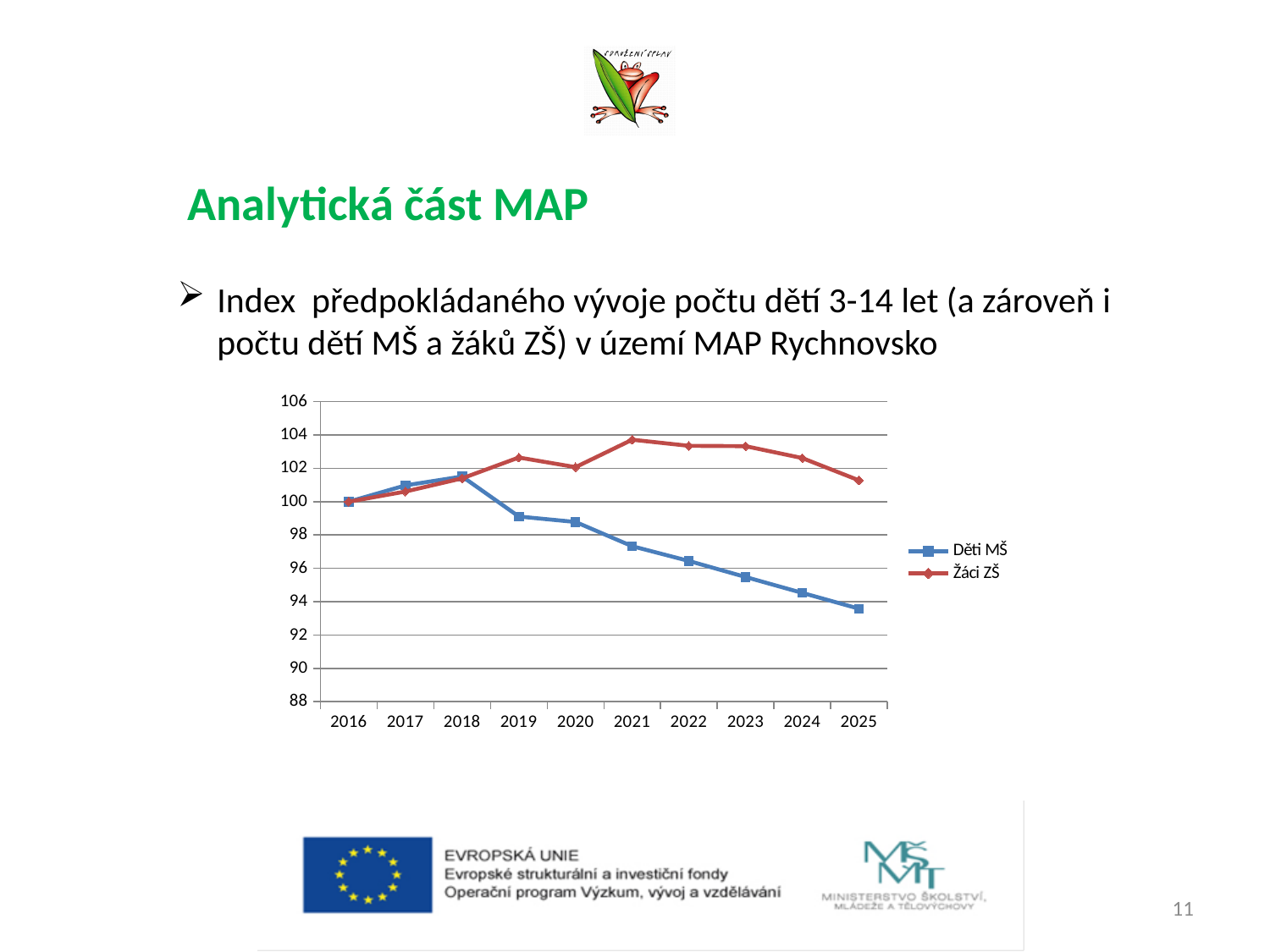
In 2023, which series has the higher value, Děti MŠ or Žáci ZŠ? Žáci ZŠ How many years are shown on the x axis of the chart? 10 Does the Děti MŠ series rise or fall between 2018 and 2025? fall Is the value for Žáci ZŠ in 2021 greater or less than 102? greater What is the value of the Děti MŠ series in 2016? 100 What is the value of the Žáci ZŠ series in 2016? 100 Is the value for Děti MŠ in 2022 greater or less than 98? less How many series does the chart legend list? 2 Is the value for Děti MŠ in 2025 greater or less than 94? less In which year does the Žáci ZŠ series reach its highest value? 2021 In which year does the Děti MŠ series reach its lowest value? 2025 What kind of chart is shown on the slide? line chart